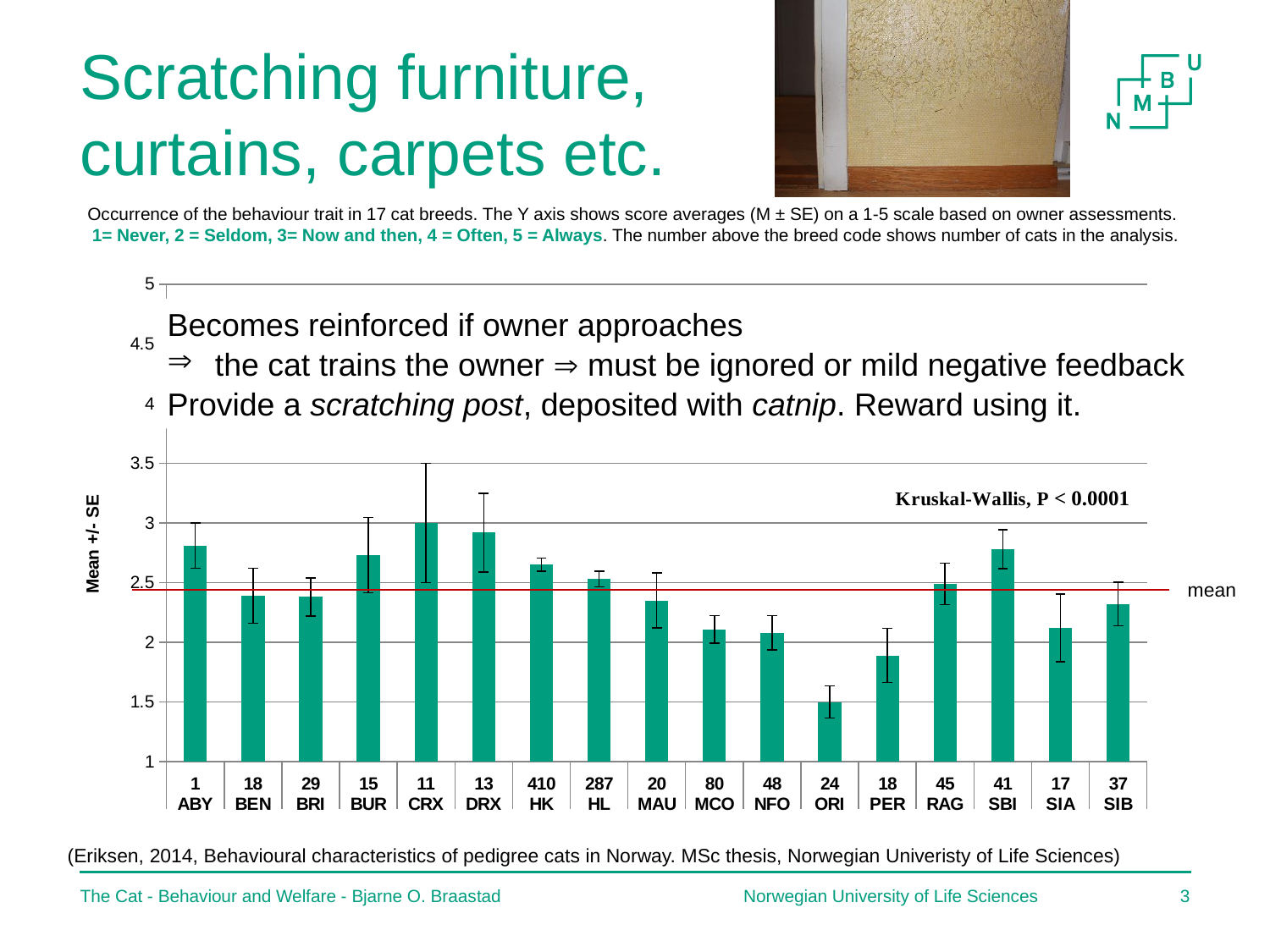
Is the mean score for ABY greater or less than 2.5? greater What is the label of the y axis of the chart? Mean +/- SE Is the mean score for ORI greater or less than 2? less Is the mean score for MAU greater or less than 2.5? less According to the number printed above the breed code, how many cats of breed HK were in the analysis? 410 Which has the higher mean score, CRX or MCO? CRX Which breed has the lowest mean score in the chart? ORI What kind of chart is shown on the slide? bar chart Which has the higher mean score, PER or ORI? PER How many cat breeds are plotted on the x axis of the chart? 17